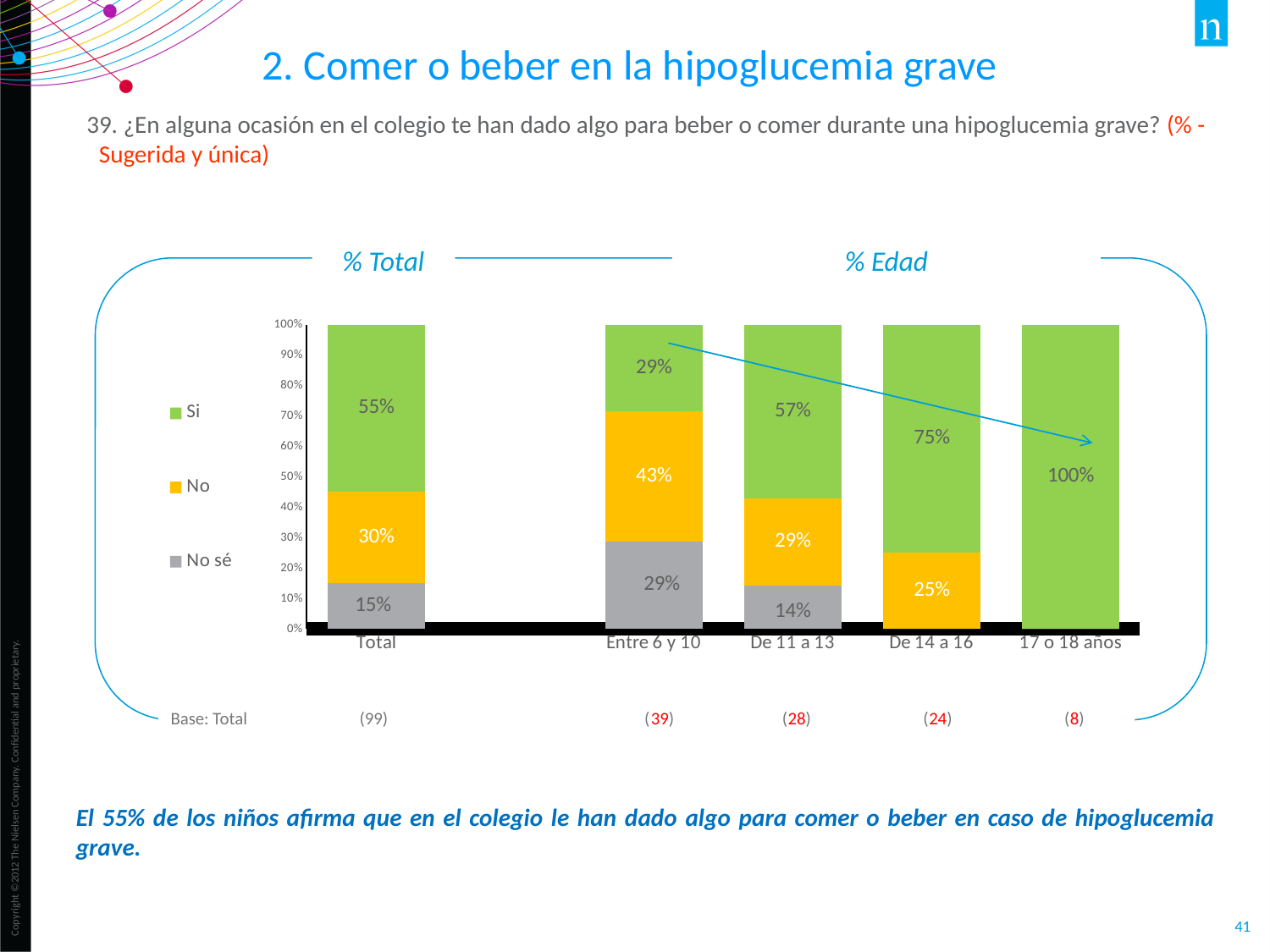
Which age group has the highest value for "Si"? 17 o 18 años What kind of chart is shown on the slide? Stacked bar chart Which age group has the lowest value for "Si"? Entre 6 y 10 Does the "Si" value rise or fall across the age groups from "Entre 6 y 10" to "17 o 18 años"? Rise How many series does the legend list? 3 What is the value for "Si" in the Total bar? 55% How many categories are shown on the x axis of the chart? 5 What is the difference between the "Si" values for "De 14 a 16" and "De 11 a 13"? 18% What is the value for "Si" in the "17 o 18 años" bar? 100% What is the value for "No sé" in the "De 11 a 13" bar? 14% What is the value for "No" in the "Entre 6 y 10" bar? 43% Which is larger: the "No" value for "Entre 6 y 10" or the "No" value for "De 14 a 16"? Entre 6 y 10